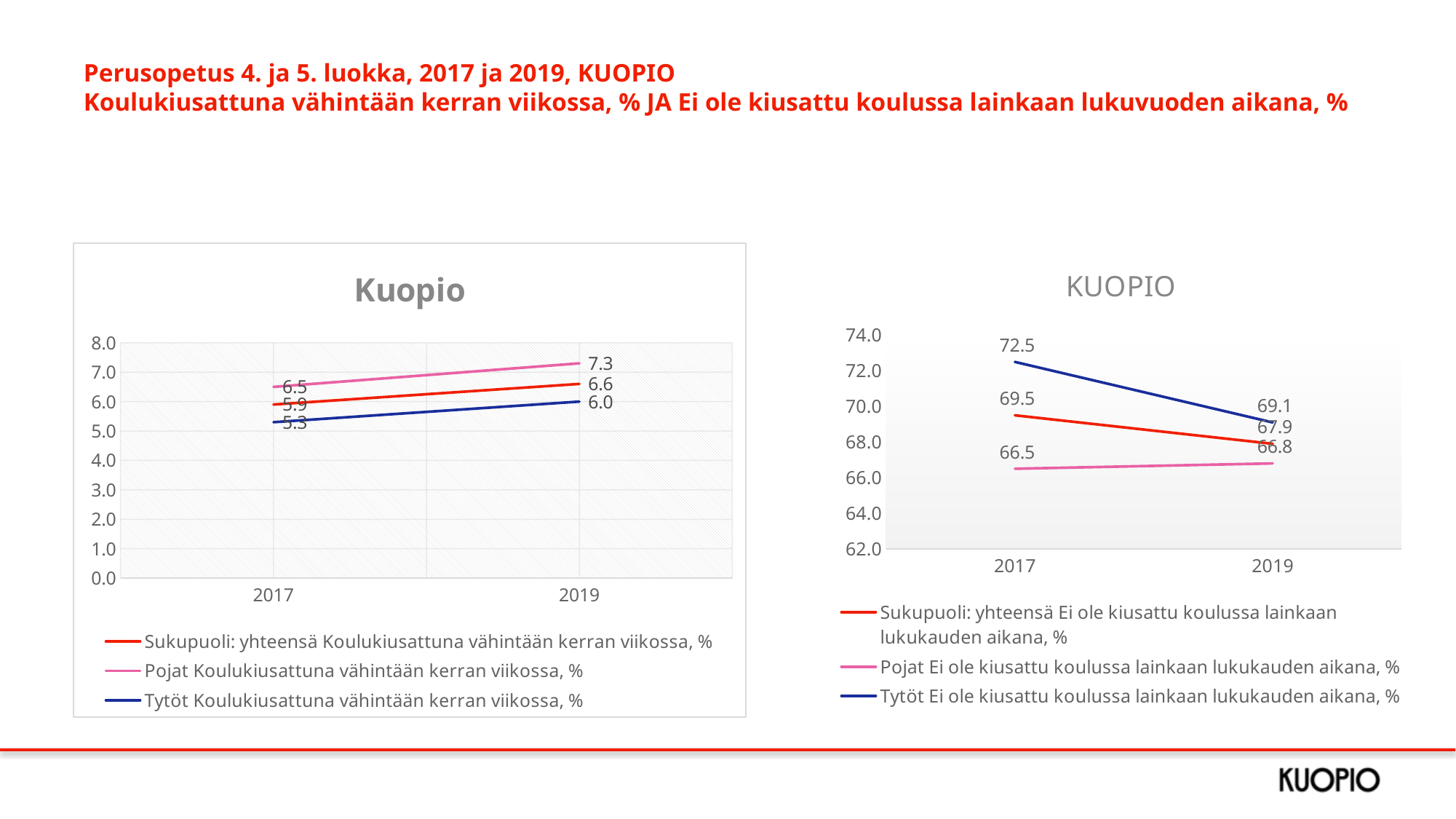
In the left chart (Kuopio), what is the value for Tytöt Koulukiusattuna vähintään kerran viikossa in 2017? 5.3 In the right chart (KUOPIO), what is the value for Pojat Ei ole kiusattu koulussa lainkaan in 2019? 66.8 How many series does the legend of the right chart (KUOPIO) list? 3 In the left chart (Kuopio), what is the value for Sukupuoli: yhteensä in 2019? 6.6 In the right chart (KUOPIO), which series has the lowest value in 2017? Pojat Ei ole kiusattu koulussa lainkaan lukukauden aikana, % In the right chart (KUOPIO), what is the difference between the Tytöt value in 2017 and in 2019? 3.4 In the right chart (KUOPIO), what is the value for Tytöt Ei ole kiusattu koulussa lainkaan in 2017? 72.5 In the left chart (Kuopio), which series has the highest value in 2019? Pojat Koulukiusattuna vähintään kerran viikossa, % In the left chart (Kuopio), what is the value for Pojat Koulukiusattuna vähintään kerran viikossa in 2019? 7.3 In the left chart (Kuopio), do the values rise or fall from 2017 to 2019? rise In the left chart (Kuopio), by how much did the Tytöt value change from 2017 to 2019? 0.7 In the right chart (KUOPIO), is the Sukupuoli: yhteensä value in 2017 or in 2019 larger? 2017